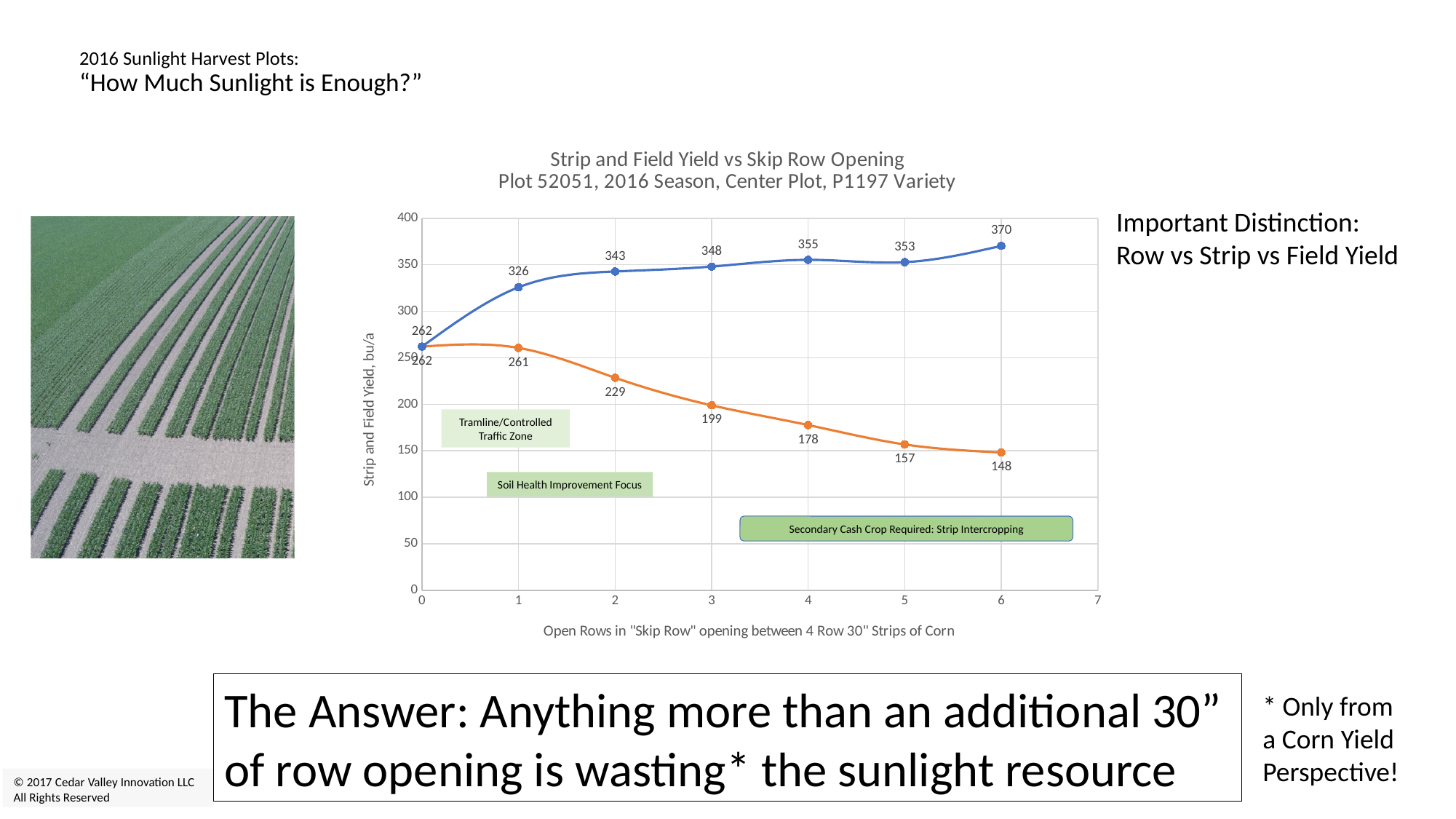
Which line has the larger value at 2 open rows, blue or orange? blue What is the value of the orange line at 3 open rows? 199 What is the difference between the blue and orange values at 4 open rows? 177 At which number of open rows does the blue line reach its highest value? 6 Does the orange line generally rise or fall as the number of open rows increases? fall At which number of open rows does the orange line reach its lowest value? 6 What is the label of the y axis of the chart? Strip and Field Yield, bu/a How many data points are plotted on the blue line? 7 What is the value of the blue line at 6 open rows? 370 What is the value of the orange line at 5 open rows? 157 What type of chart is shown on the slide? line chart What is the value of the blue line at 1 open row? 326